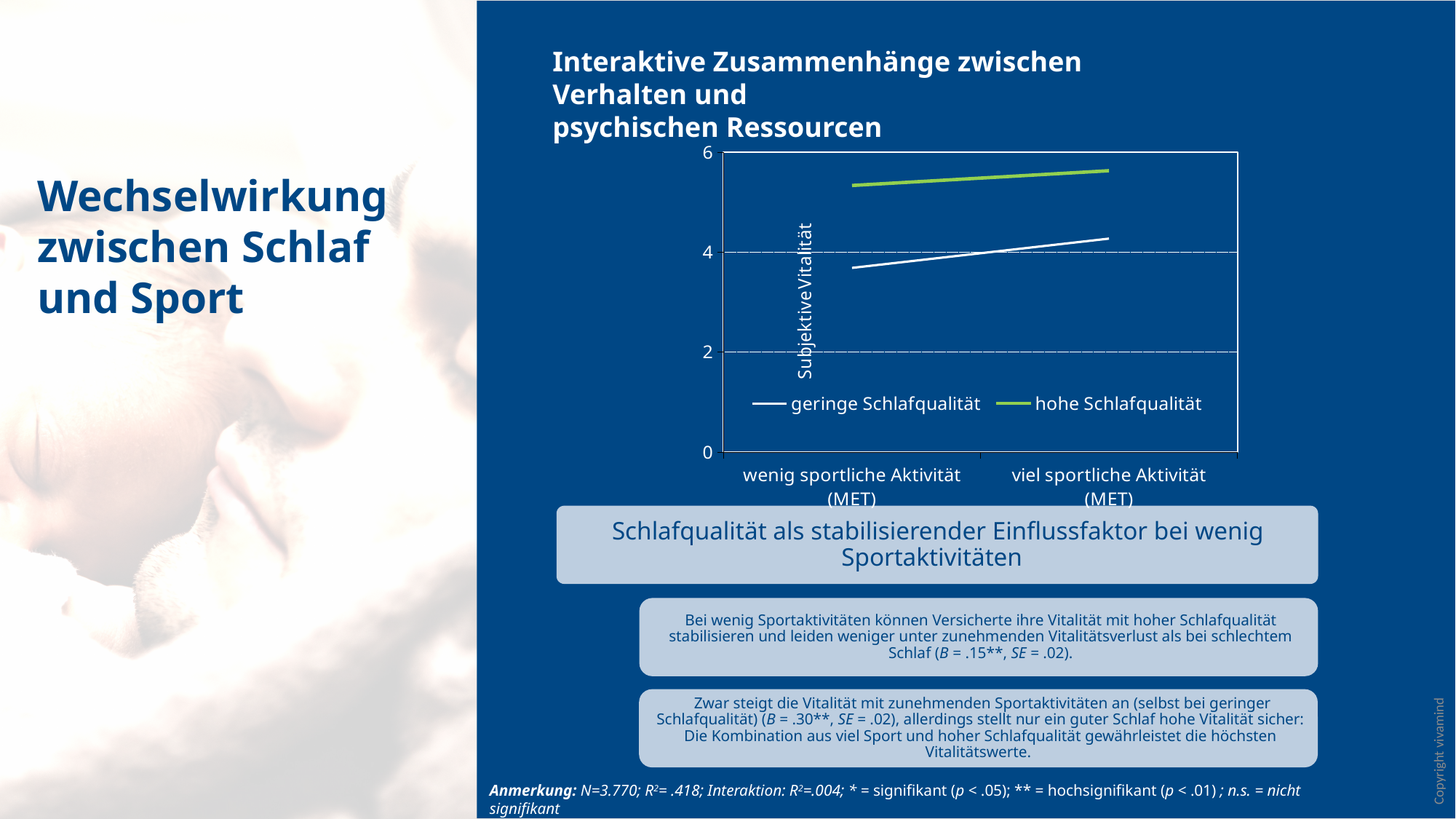
Which series has the higher value at 'wenig sportliche Aktivität (MET)'? hohe Schlafqualität How many series does the legend list? 2 How many categories are shown on the x axis? 2 What is the label of the y axis? Subjektive Vitalität Which series has the higher value at 'viel sportliche Aktivität (MET)'? hohe Schlafqualität Is the value for 'geringe Schlafqualität' at 'wenig sportliche Aktivität (MET)' greater or less than 4? less What kind of chart is shown on the slide? line chart Does the 'geringe Schlafqualität' line rise or fall from 'wenig sportliche Aktivität' to 'viel sportliche Aktivität'? rise Is the value for 'hohe Schlafqualität' at 'wenig sportliche Aktivität (MET)' greater or less than 4? greater Is the value for 'geringe Schlafqualität' at 'viel sportliche Aktivität (MET)' greater or less than 4? greater Which colour is used for the 'hohe Schlafqualität' line? green